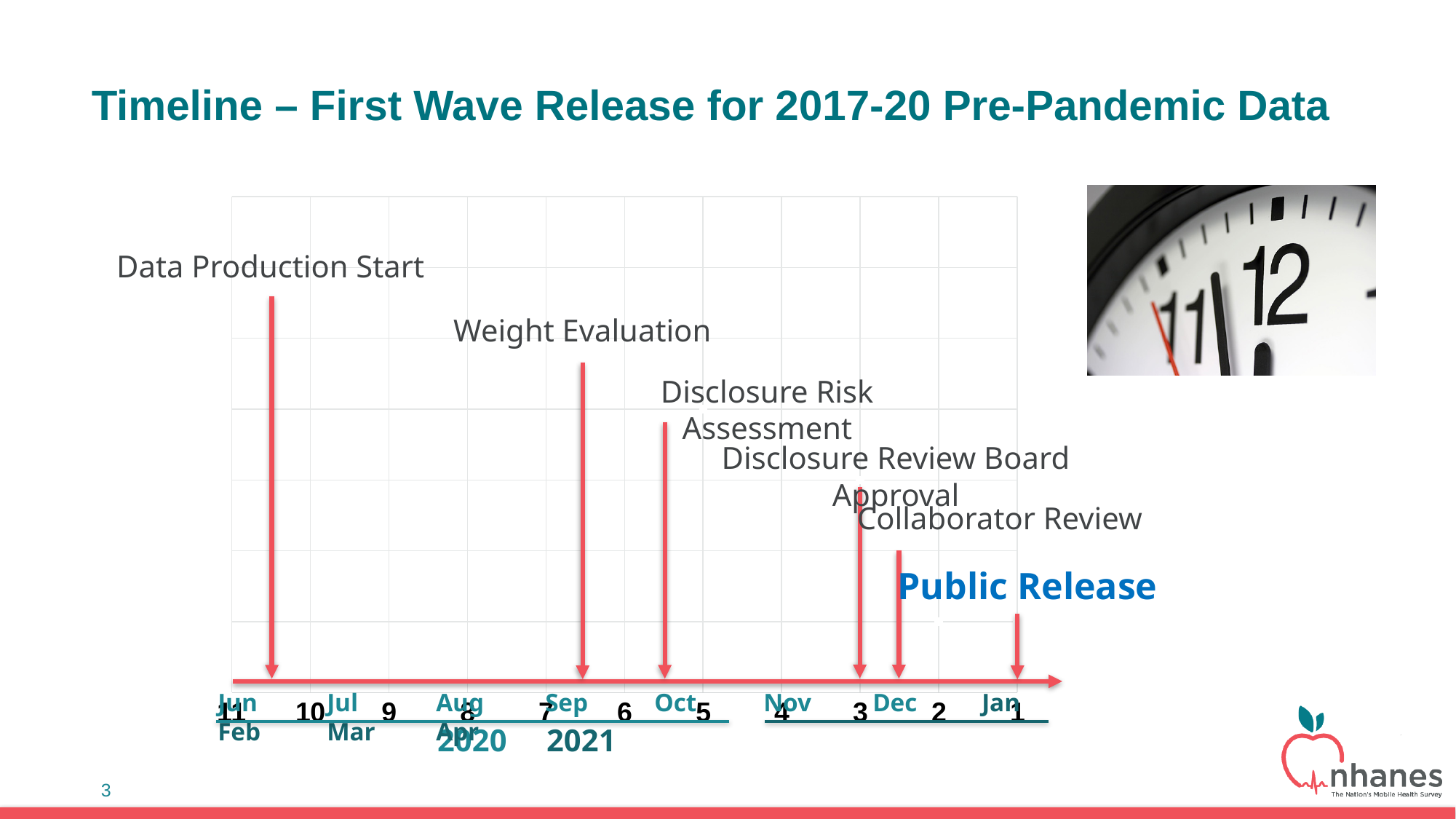
How many milestones are marked with arrows on the timeline? 6 In which month does the Collaborator Review milestone fall? Dec What kind of chart is shown on the slide? Timeline chart What is the title of the chart on the slide? Timeline – First Wave Release for 2017-20 Pre-Pandemic Data In which month does the Weight Evaluation milestone fall? Sep Which milestone is the last on the timeline? Public Release Which milestone label is shown in blue text on the timeline? Public Release In which month does the Public Release milestone fall? Jan Which milestone immediately follows Weight Evaluation on the timeline? Disclosure Risk Assessment Which comes earlier on the timeline, Disclosure Risk Assessment or Disclosure Review Board Approval? Disclosure Risk Assessment Which milestone is the first on the timeline? Data Production Start